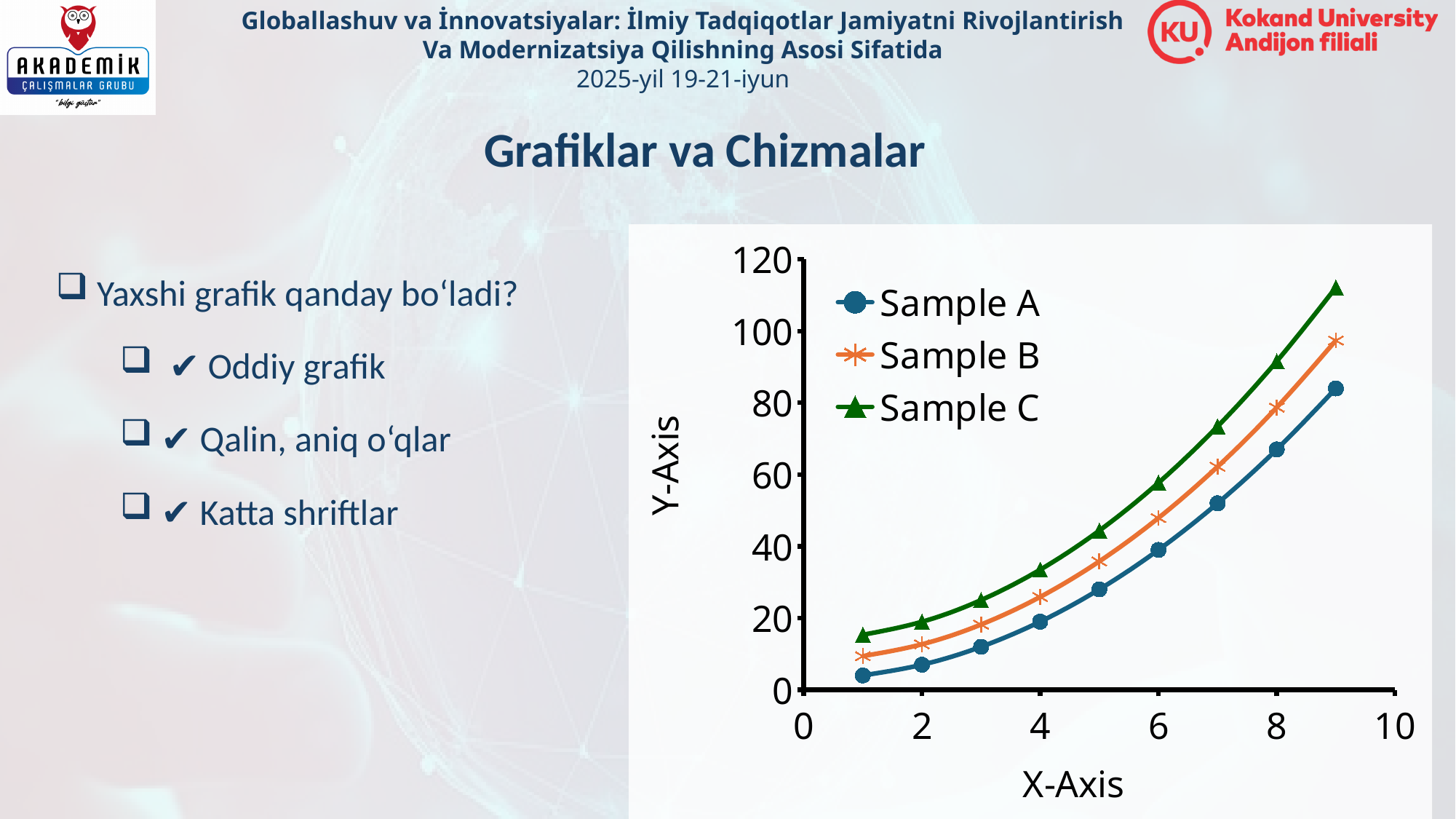
At x = 7, is the value for Sample C greater or less than 60? greater Which series has the highest value at x = 9? Sample C At x = 8, which is larger: the value for Sample B or the value for Sample A? Sample B What kind of chart is shown on the slide? line chart At x = 9, is the value for Sample C greater or less than 100? greater At x = 1, is the value for Sample A greater or less than 20? less How many data points are plotted for Sample A? 9 What is the title of the vertical axis of the chart? Y-Axis How many series does the chart's legend list? 3 Do the values of Sample C rise or fall as the x axis increases? rise Which series has the lowest value at x = 1? Sample A